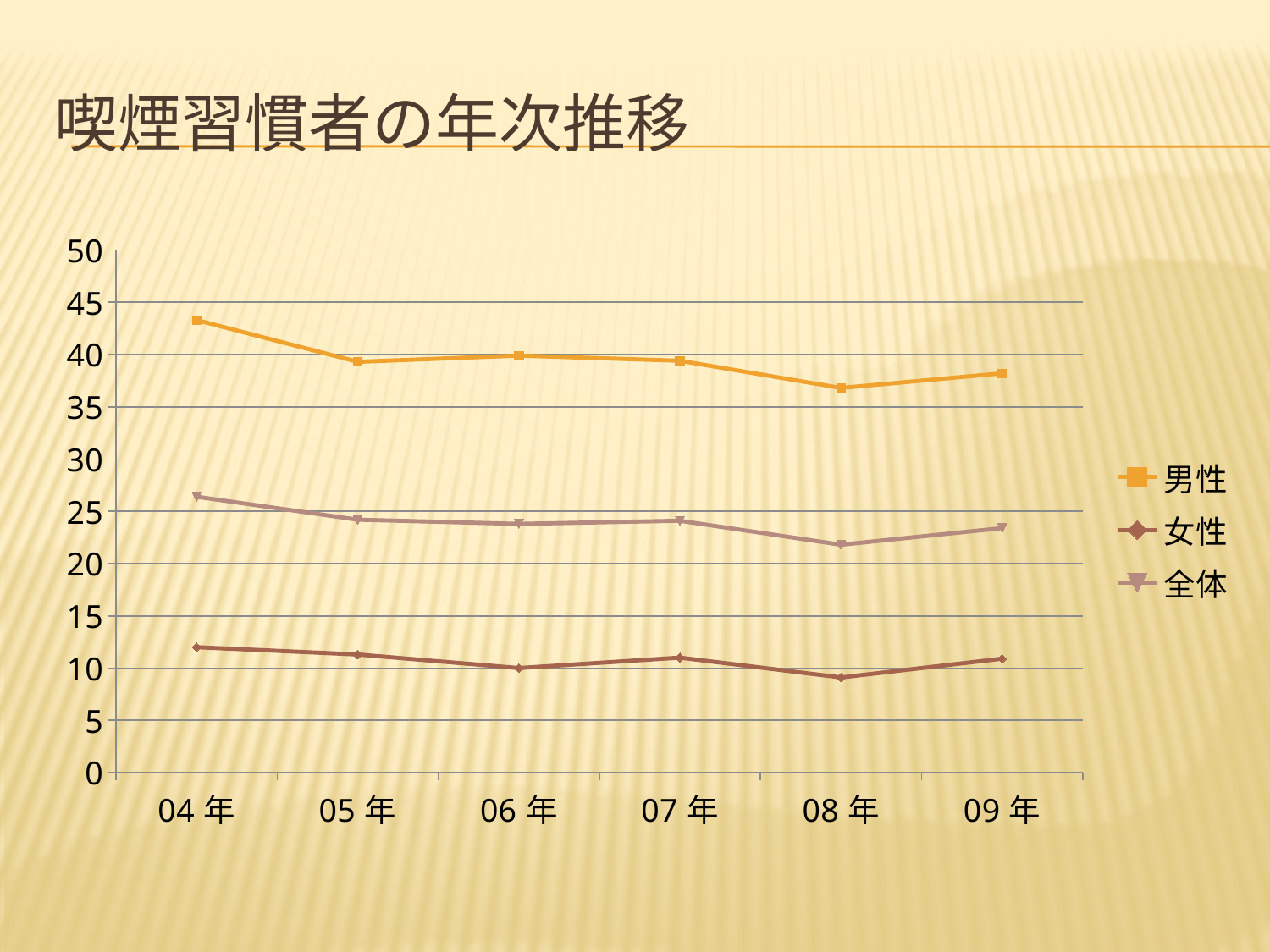
In which year is the value for 男性 highest? 04 年 Does the value for 男性 rise or fall from 04 年 to 05 年? fall Which series is plotted with the orange line and square markers? 男性 In which year is the value for 男性 lowest? 08 年 Which is larger, the value for 全体 in 04 年 or the value for 全体 in 09 年? 04 年 What is the title of the chart on the slide? 喫煙習慣者の年次推移 Is the value for 女性 in 08 年 greater or less than 10? less In which year is the value for 全体 lowest? 08 年 What kind of chart is shown on the slide? line chart How many series does the legend list? 3 How many years are shown along the x axis? 6 Is the value for 男性 in 04 年 greater or less than 40? greater